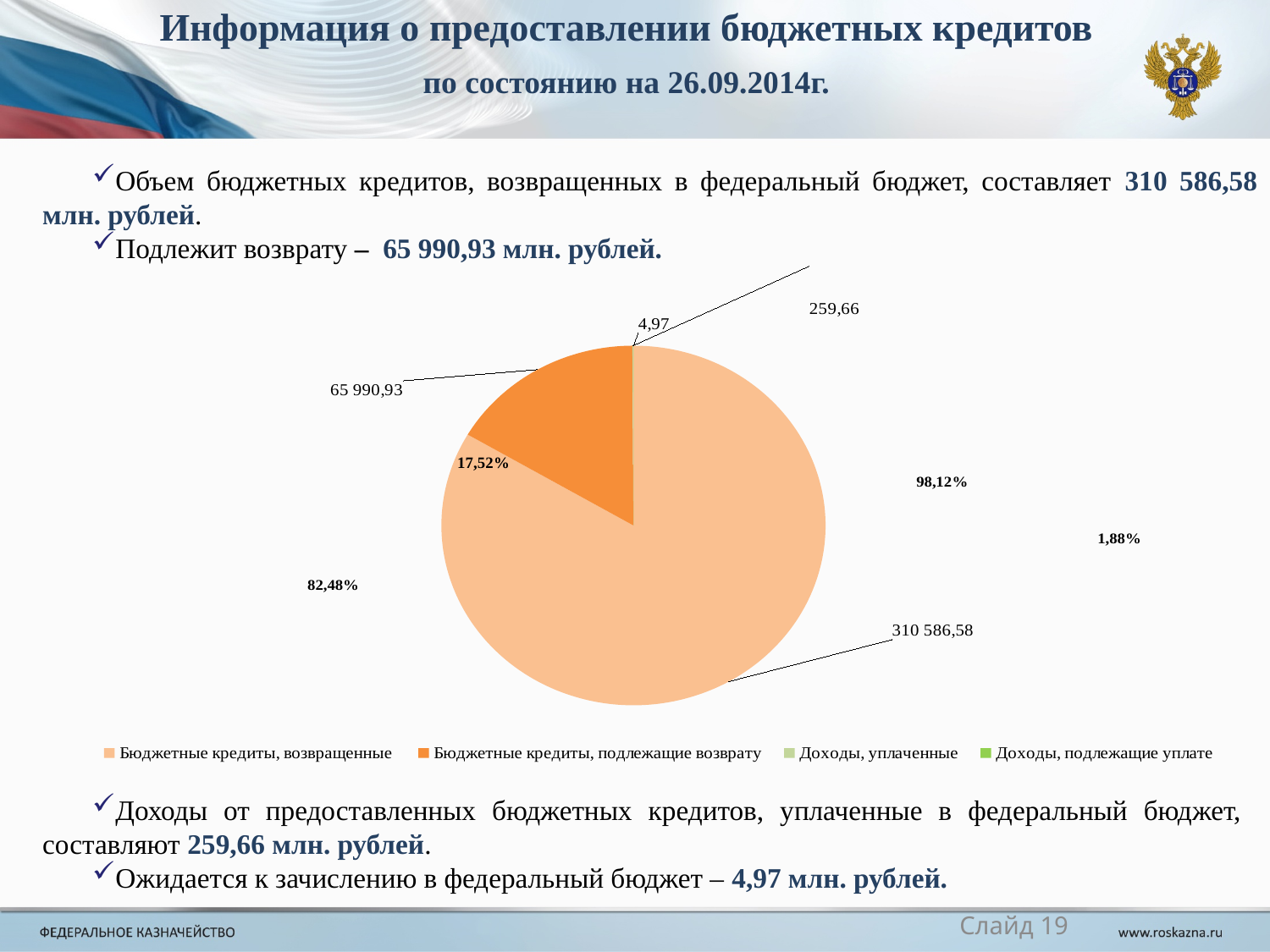
What percentage label is shown next to the "Бюджетные кредиты, подлежащие возврату" slice? 17,52% What is the value shown for "Доходы, уплаченные"? 259,66 What is the value shown for "Доходы, подлежащие уплате"? 4,97 Which is larger: the value for "Бюджетные кредиты, подлежащие возврату" or the value for "Доходы, уплаченные"? Бюджетные кредиты, подлежащие возврату Which category has the smallest value in the chart? Доходы, подлежащие уплате What kind of chart is shown on the slide? pie chart What percentage label is shown next to the "Бюджетные кредиты, возвращенные" slice? 82,48% What is the value shown for "Бюджетные кредиты, возвращенные"? 310 586,58 How many entries does the chart legend list? 4 Which category has the largest slice of the pie? Бюджетные кредиты, возвращенные What colour is the slice for "Бюджетные кредиты, подлежащие возврату"? orange What is the value shown for "Бюджетные кредиты, подлежащие возврату"? 65 990,93